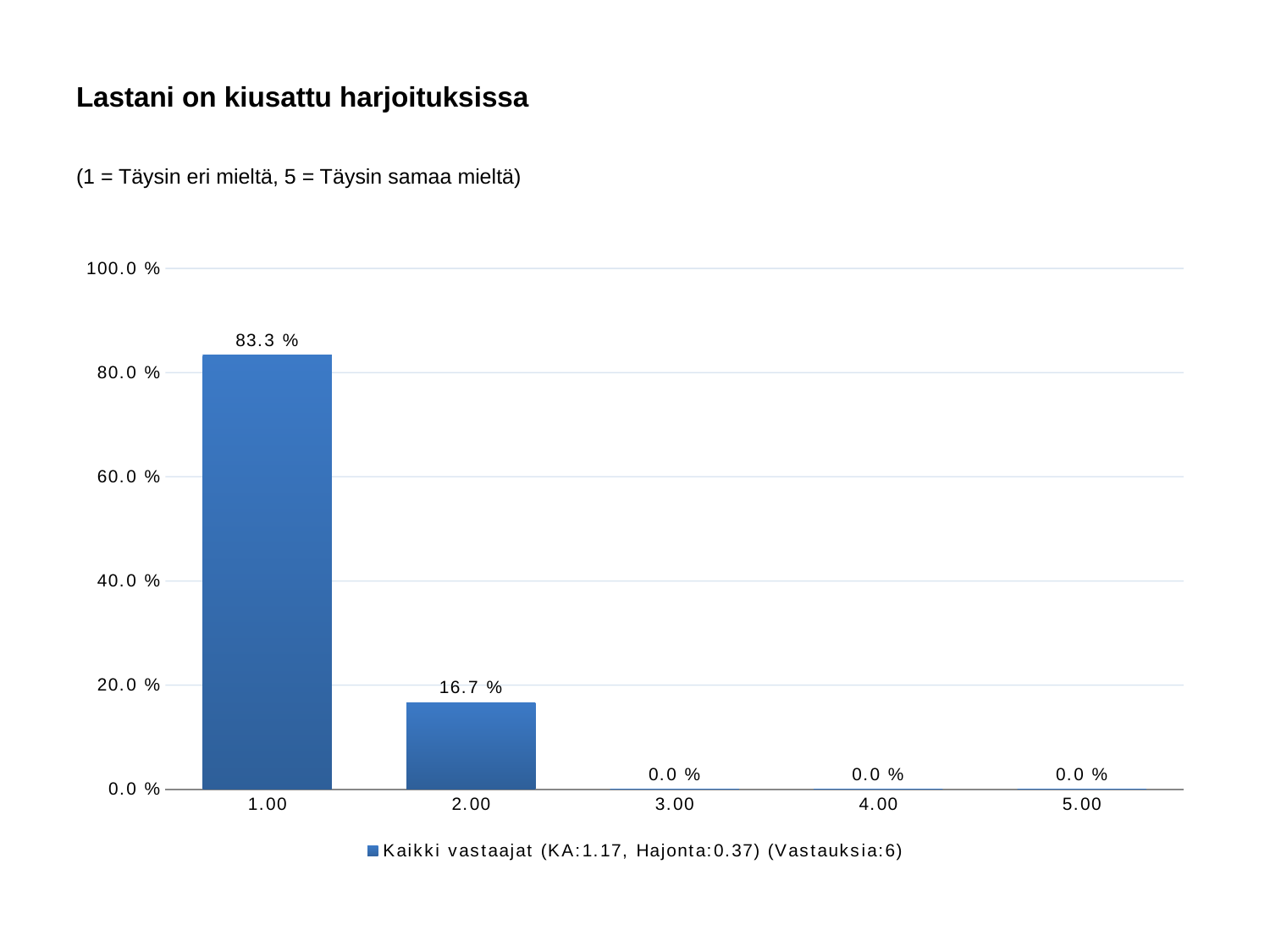
How many categories are shown on the x axis? 5 Which is larger, the value for 1.00 or the value for 2.00? 1.00 How many series does the legend list? 1 Is the value for 1.00 greater or less than 80.0 %? greater What is the difference between the values for 1.00 and 2.00? 66.6 % What is the value for category 4.00? 0.0 % What is the value for category 1.00? 83.3 % What kind of chart is shown? bar chart Is the value for 2.00 greater or less than 20.0 %? less What is the title of the chart? Lastani on kiusattu harjoituksissa Which category has the highest value? 1.00 What is the value for category 2.00? 16.7 %